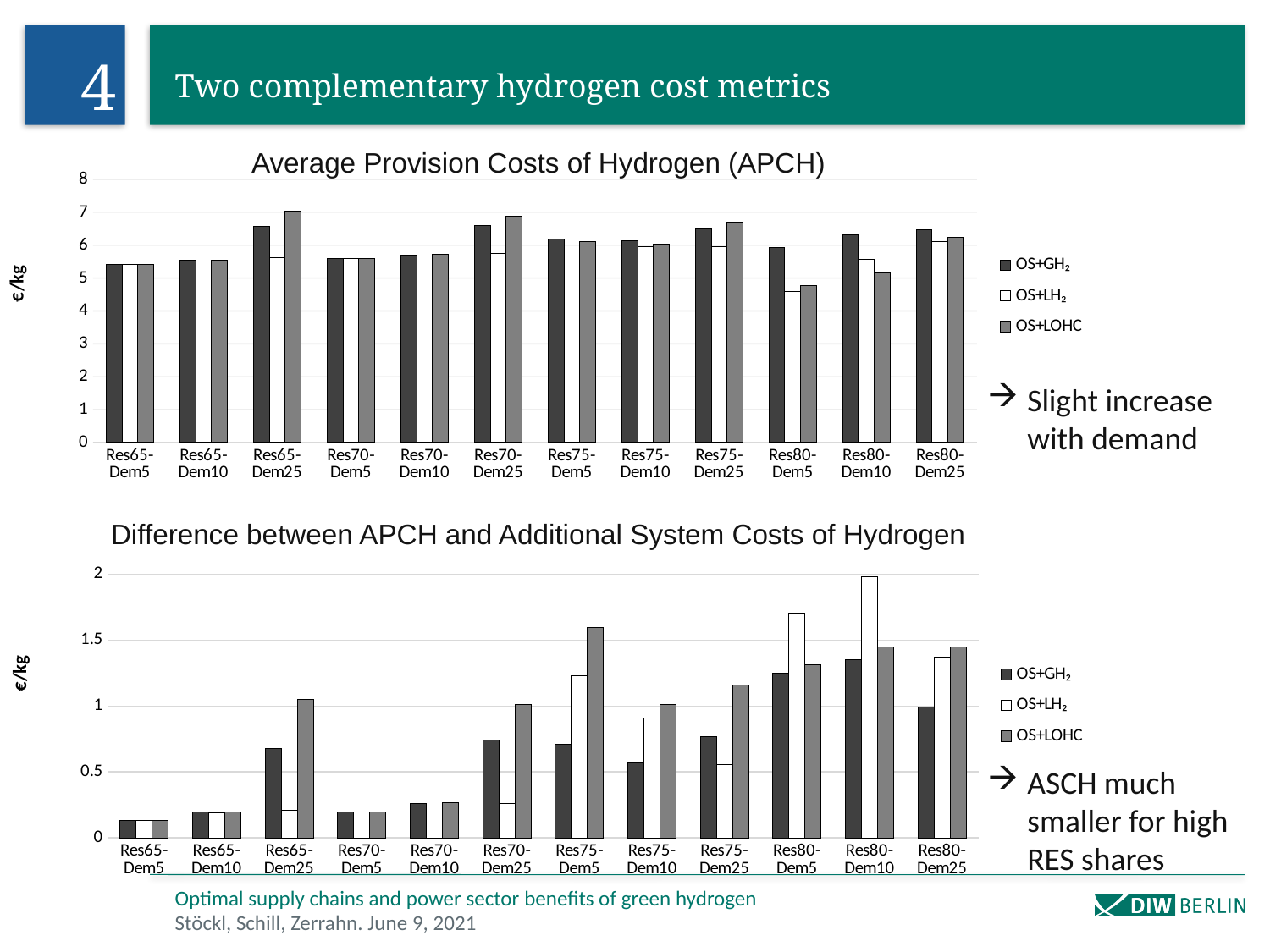
In the bottom chart (Difference between APCH and Additional System Costs of Hydrogen), is the OS+LOHC value for Res65-Dem25 greater or less than 0.5? greater In the bottom chart (Difference between APCH and Additional System Costs of Hydrogen), is the OS+LH₂ value for Res80-Dem10 greater or less than 1.5? greater In the top chart (APCH), is the OS+LH₂ value for Res80-Dem5 greater or less than 5? less How many categories are shown on the x axis of the bottom chart (Difference between APCH and Additional System Costs of Hydrogen)? 12 In the top chart (APCH), which category has the lowest OS+LH₂ bar? Res80-Dem5 How many series does the legend of the top chart (APCH) list? 3 In the bottom chart (Difference between APCH and Additional System Costs of Hydrogen), which is larger for OS+GH₂: Res65-Dem5 or Res80-Dem5? Res80-Dem5 What kind of chart is the top chart titled 'Average Provision Costs of Hydrogen (APCH)'? bar chart What unit is shown on the y axis of the bottom chart (Difference between APCH and Additional System Costs of Hydrogen)? €/kg In the bottom chart (Difference between APCH and Additional System Costs of Hydrogen), which category has the highest OS+LH₂ bar? Res80-Dem10 In the top chart (APCH), does the OS+LOHC value rise or fall from Res65-Dem5 to Res65-Dem25? rise